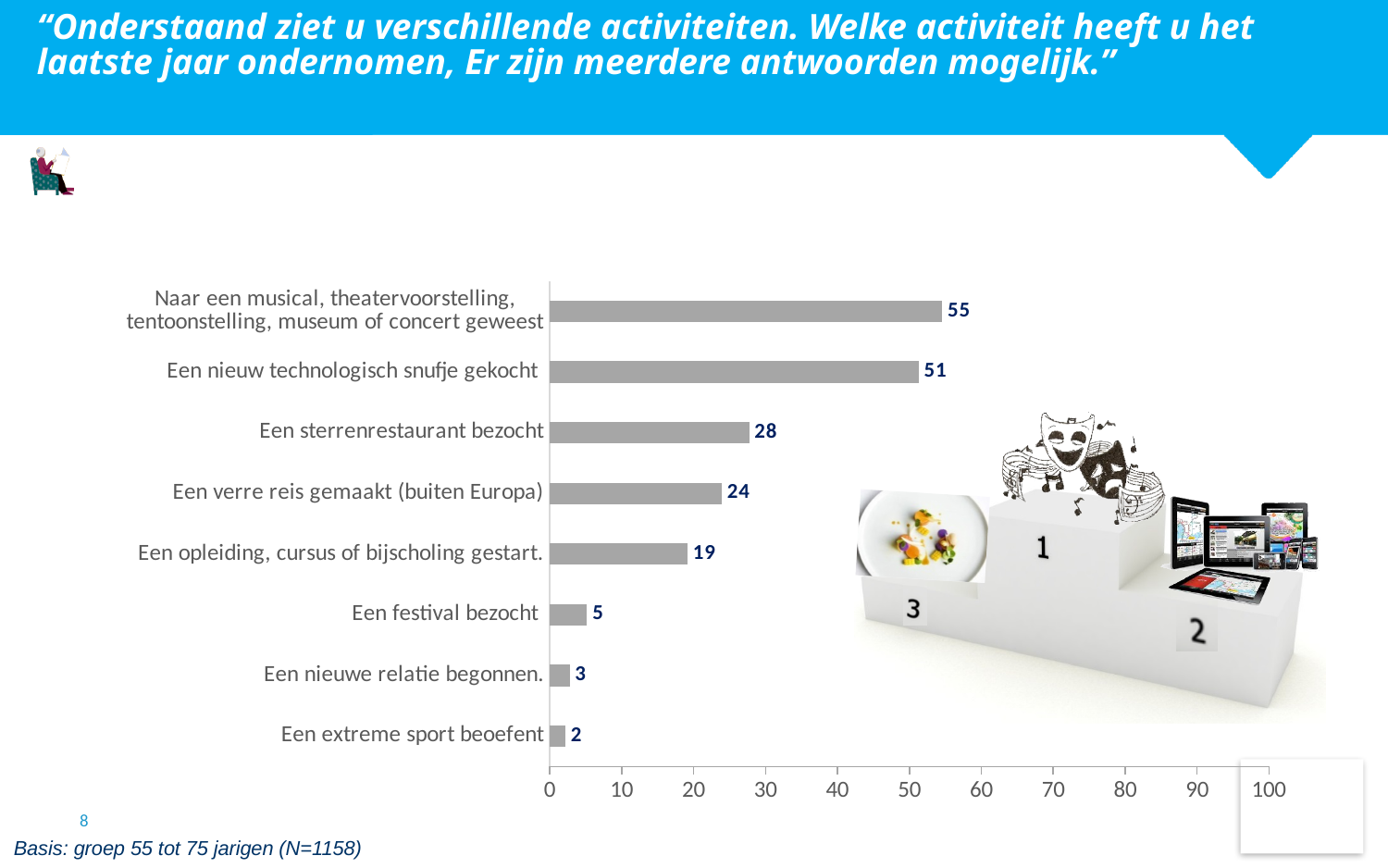
What is the value for "Een nieuw technologisch snufje gekocht"? 51 Is the value for "Een nieuw technologisch snufje gekocht" greater or less than 40? greater What kind of chart is shown on the slide? bar chart Which is larger: the value for "Een nieuwe relatie begonnen." or the value for "Een festival bezocht"? Een festival bezocht Which activity has the lowest value? Een extreme sport beoefent What is the value for "Een verre reis gemaakt (buiten Europa)"? 24 What is the value for "Een festival bezocht"? 5 Which activity has the highest value? Naar een musical, theatervoorstelling, tentoonstelling, museum of concert geweest What is the difference between the values for "Een sterrenrestaurant bezocht" and "Een opleiding, cursus of bijscholing gestart."? 9 What is the highest tick value shown on the horizontal axis? 100 What is the difference between the highest and lowest values in the chart? 53 How many activities are shown in the chart? 8